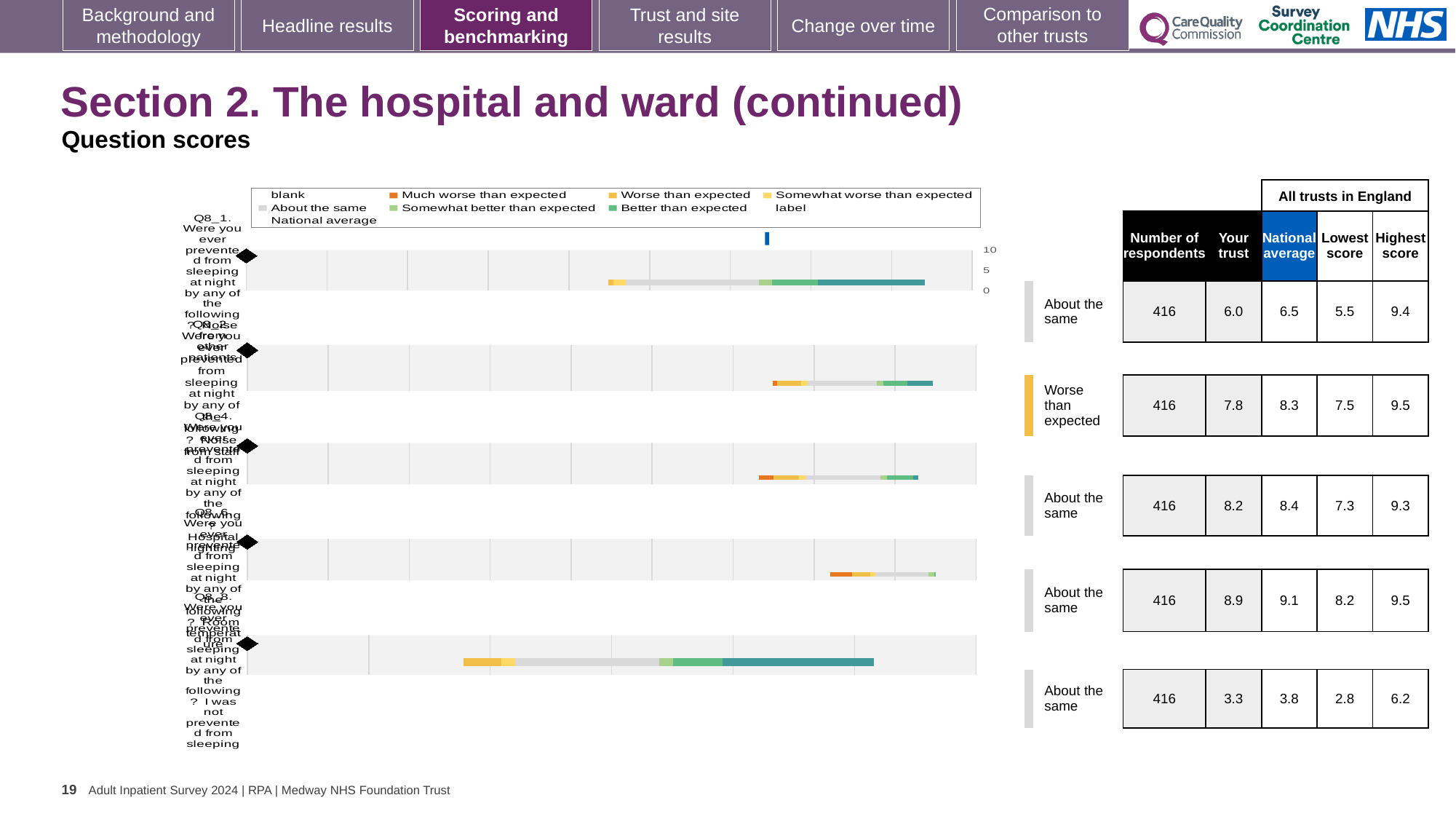
For the last (bottom) row, what is the difference between the national average and the 'Your trust' score? 0.5 How many of the five rows are rated 'About the same'? 4 In the table, what is the 'Your trust' score for the row rated 'Worse than expected'? 7.8 For the second row, what is the difference between the highest score and the lowest score across all trusts in England? 2.0 What kind of chart is shown on the slide? bar chart In the table, what is the national average for the row rated 'Worse than expected'? 8.3 How many respondents are listed for each question in the table? 416 What is the lowest 'Your trust' score shown in the table? 3.3 What is the highest score across all trusts in England for the last (bottom) row? 6.2 How many question rows (bars) does the chart show? 5 What is the highest 'Your trust' score shown in the table? 8.9 For the first (top) row, which is larger: the 'Your trust' score or the national average? National average